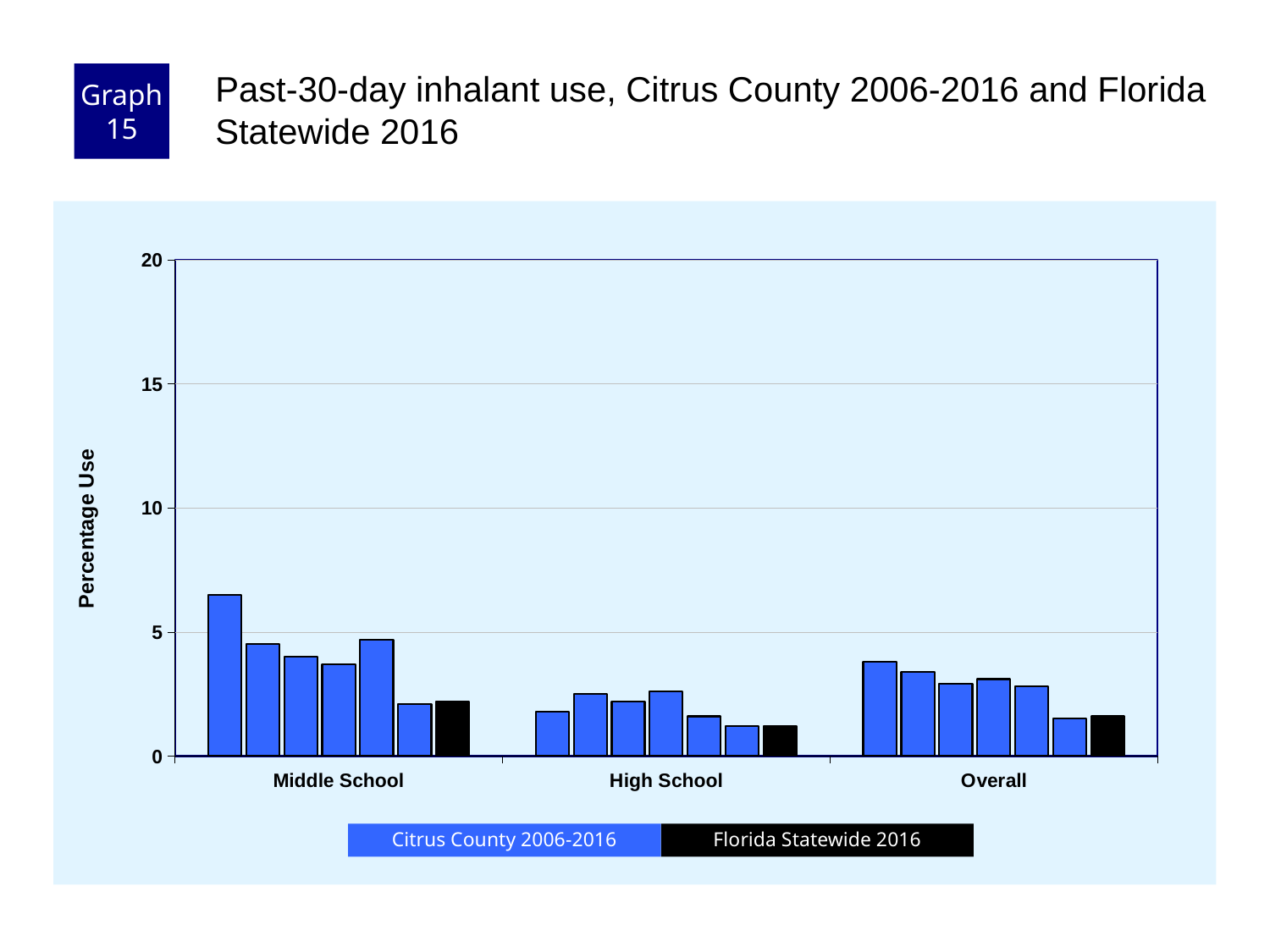
What kind of chart is shown on the slide? bar chart How many categories are shown on the x axis? 3 What is the label on the y axis? Percentage Use Which colour represents Florida Statewide 2016 in the legend? black Is the Florida Statewide 2016 value for Overall greater or less than 5? less Which category group contains the tallest bar in the chart? Middle School How many series does the legend list? 2 Which is larger: the Florida Statewide 2016 bar for Middle School or the Florida Statewide 2016 bar for High School? Middle School Is the tallest Middle School bar greater or less than 5? greater Is the Florida Statewide 2016 value for High School greater or less than 5? less Which is larger: the first Citrus County bar for Middle School or the first Citrus County bar for High School? Middle School